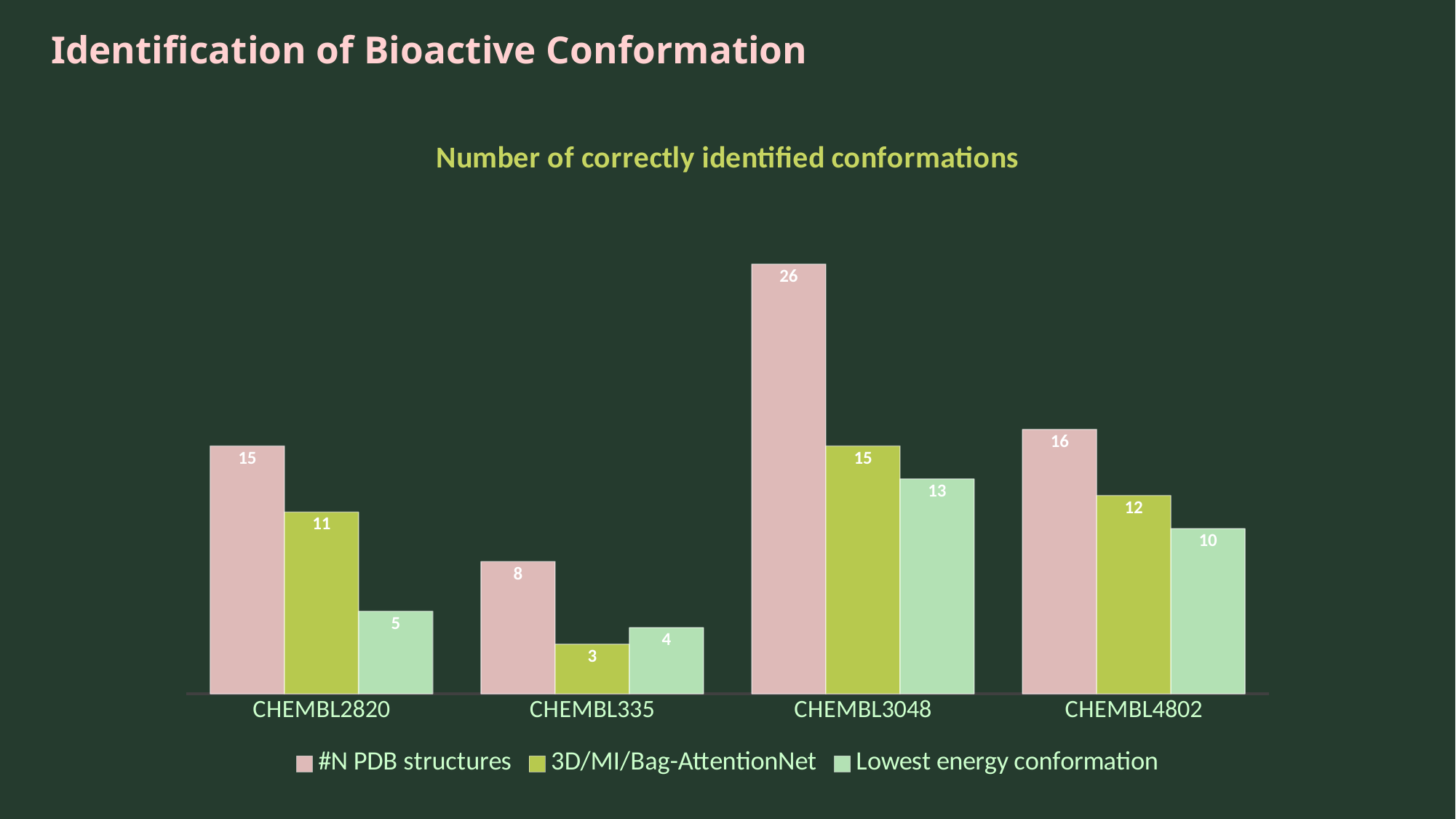
How many categories are shown on the x axis? 4 What kind of chart is shown on the slide? Bar chart Which is larger for CHEMBL2820: 3D/MI/Bag-AttentionNet or Lowest energy conformation? 3D/MI/Bag-AttentionNet How many series does the legend list? 3 What is the value of #N PDB structures for CHEMBL3048? 26 What is the difference between #N PDB structures and 3D/MI/Bag-AttentionNet for CHEMBL3048? 11 What is the value of 3D/MI/Bag-AttentionNet for CHEMBL335? 3 What is the value of 3D/MI/Bag-AttentionNet for CHEMBL2820? 11 What is the value of Lowest energy conformation for CHEMBL4802? 10 Which category has the lowest value for Lowest energy conformation? CHEMBL335 Which category has the highest value for #N PDB structures? CHEMBL3048 What is the title of the chart? Number of correctly identified conformations